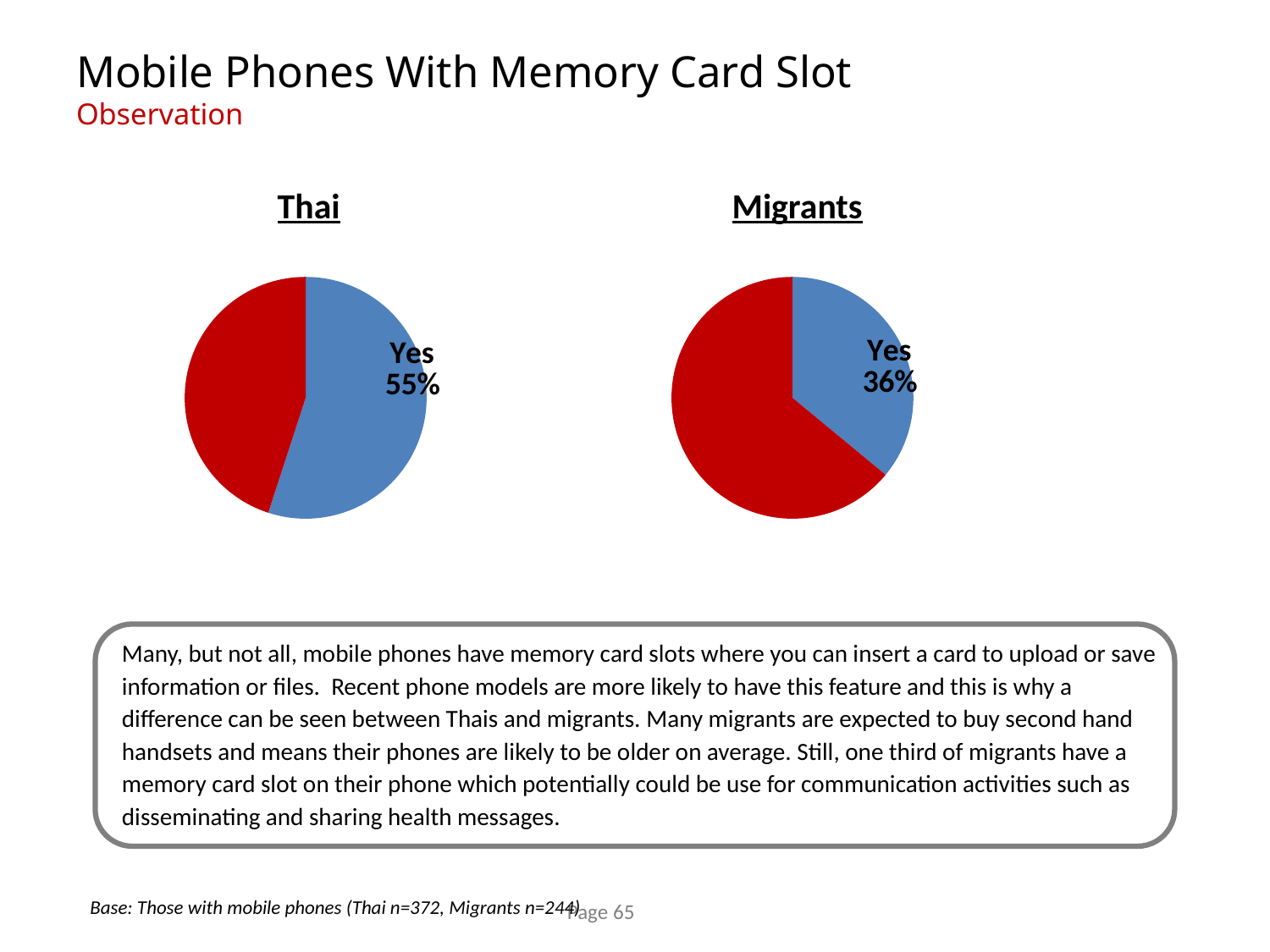
What colour is the 'Yes' slice in the Thai pie chart? blue How many slices does the Migrants pie chart have? 2 Which pie chart has the larger 'Yes' slice, Thai or Migrants? Thai What is the difference in percentage points between the 'Yes' share in the Thai pie chart and the 'Yes' share in the Migrants pie chart? 19 percentage points In the Migrants pie chart, is the 'Yes' slice greater or less than 50% of the pie? less What are the titles of the two pie charts on the slide? Thai and Migrants In the Thai pie chart, is the 'Yes' slice greater or less than 50% of the pie? greater In the Migrants pie chart, which slice is larger, the blue 'Yes' slice or the red slice? the red slice What kind of chart is used for the Thai data? pie chart In the Migrants pie chart, what share of the pie is the 'Yes' slice? 36% In the Thai pie chart, what share of the pie is the 'Yes' slice? 55% How many slices does the Thai pie chart have? 2